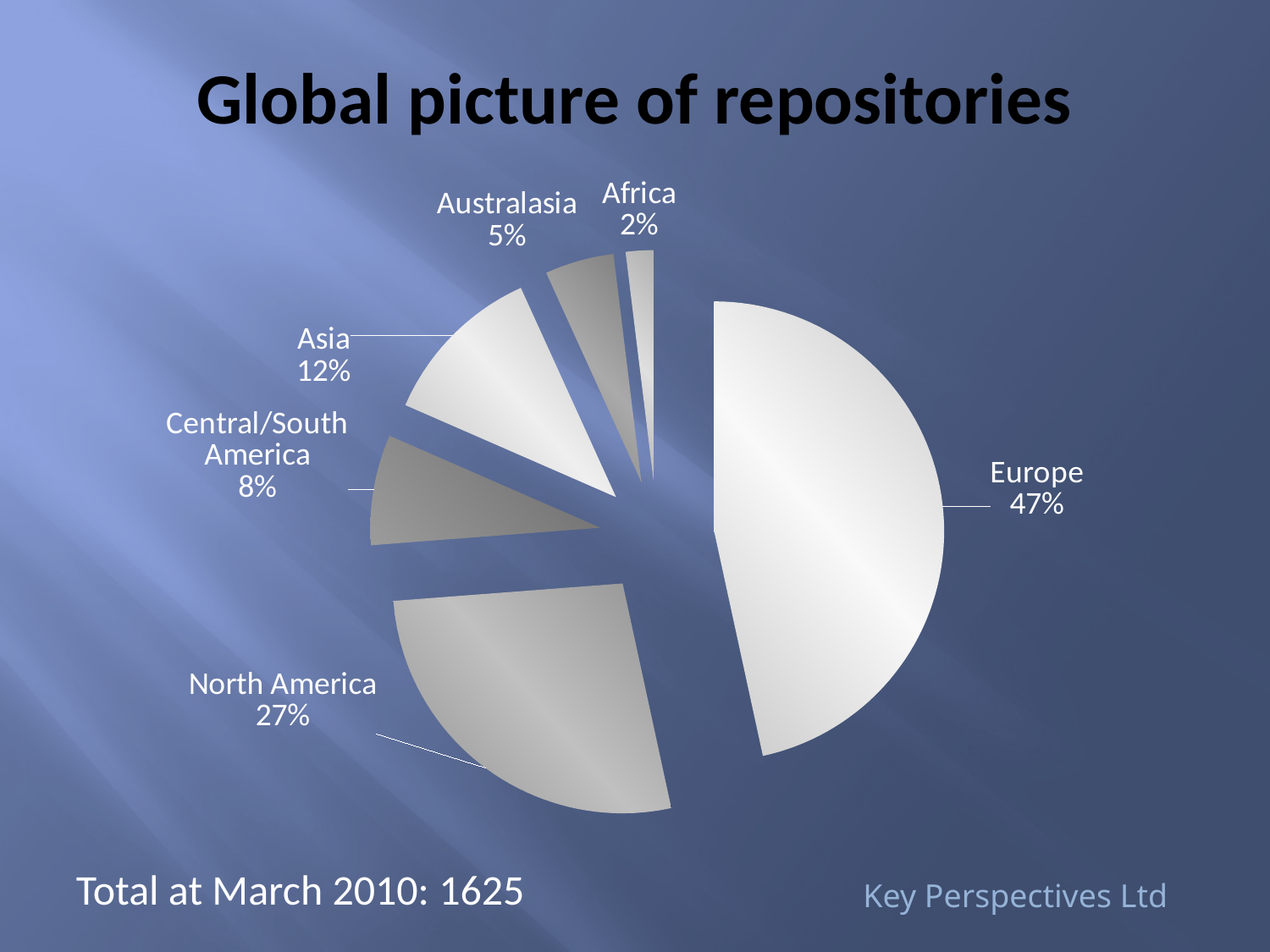
What share of repositories does Europe account for in the pie chart? 47% What is the title of the chart on the slide? Global picture of repositories What type of chart is shown on the slide? Pie chart What percentage does Central/South America hold? 8% What is the difference in percentage points between Europe's share and North America's share? 20 Which has a larger share, Asia or Central/South America? Asia What is the share for Asia in the pie chart? 12% What is the share shown for Australasia? 5% Which region has the largest share of repositories? Europe What percentage of repositories is attributed to North America? 27% Which region has the smallest share of repositories? Africa How many regions are shown in the pie chart? 6